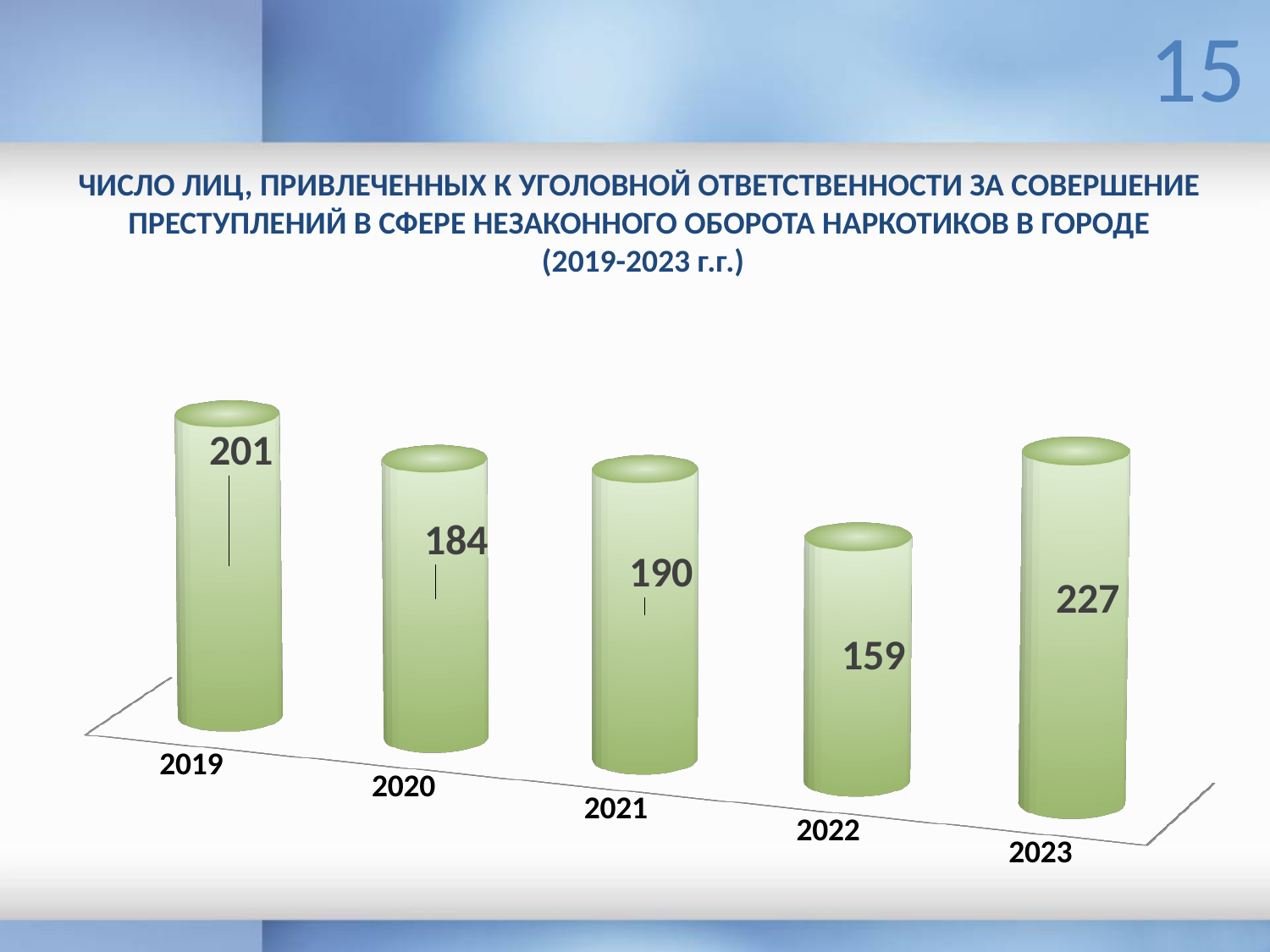
What kind of chart is shown on the slide? bar chart What colour are the bars on the chart? green Which year has the highest value? 2023 Does the value rise or fall from 2022 to 2023? rise How many years are shown on the chart? 5 What is the value for 2022? 159 What is the value for 2019? 201 What is the difference between the values for 2019 and 2020? 17 What is the value for 2023? 227 What is the difference between the values for 2023 and 2022? 68 Which year has the lowest value? 2022 Which is larger, the value for 2020 or the value for 2021? 2021